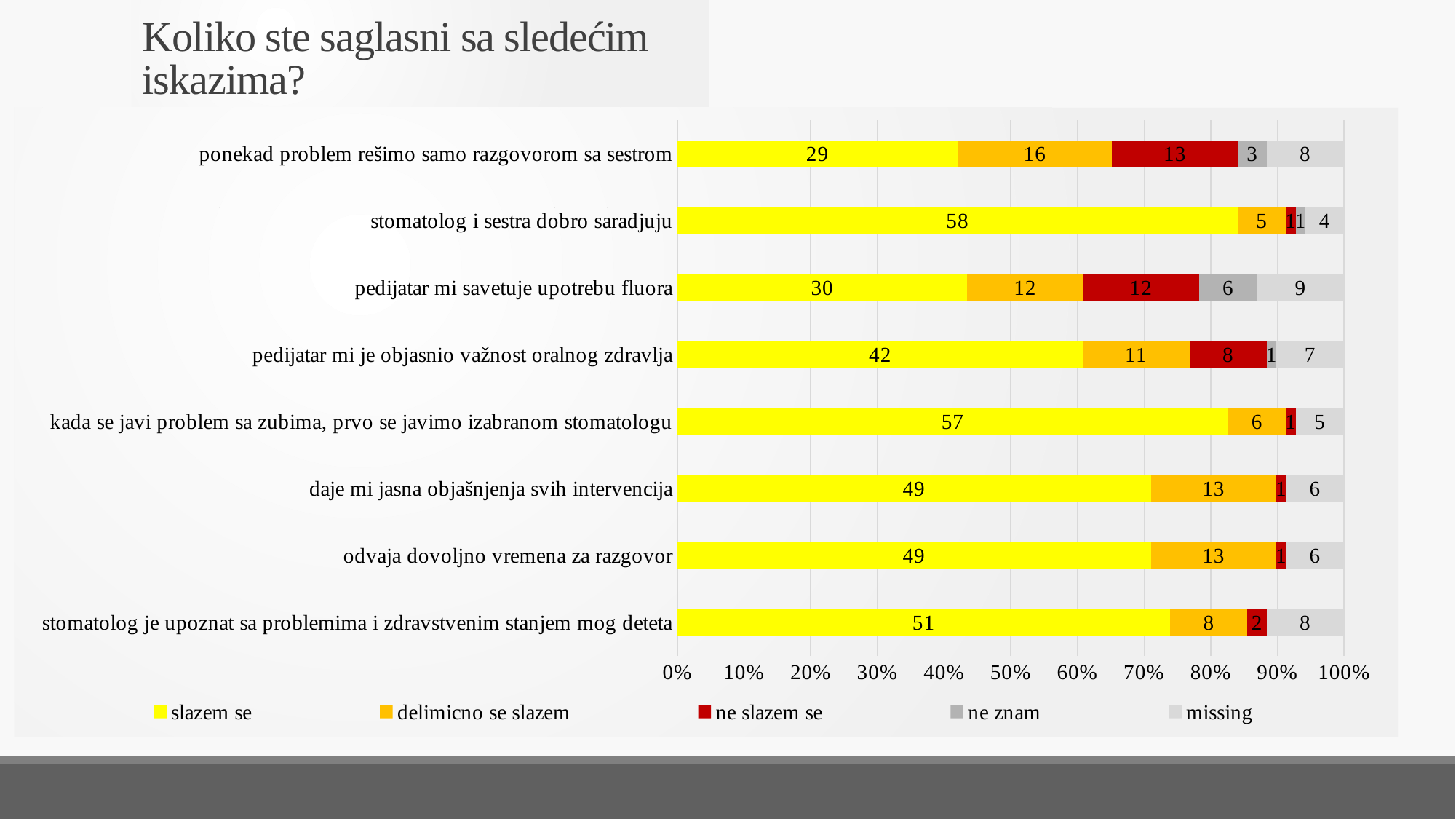
What is the 'slazem se' value for 'stomatolog i sestra dobro saradjuju'? 58 How many statements (categories) are shown in the chart? 8 What is the 'ne slazem se' value for 'ponekad problem rešimo samo razgovorom sa sestrom'? 13 What is the 'missing' value for 'pedijatar mi savetuje upotrebu fluora'? 9 What type of chart is shown on the slide? stacked bar chart How many series does the legend list? 5 Which statement has the lowest 'slazem se' value? ponekad problem rešimo samo razgovorom sa sestrom What is the 'delimicno se slazem' value for 'pedijatar mi je objasnio važnost oralnog zdravlja'? 11 Which colour represents 'ne slazem se' in the legend? red What is the difference between the 'slazem se' values for 'stomatolog i sestra dobro saradjuju' and 'ponekad problem rešimo samo razgovorom sa sestrom'? 29 Which statement has the highest 'slazem se' value? stomatolog i sestra dobro saradjuju Which has a larger 'ne znam' value: 'pedijatar mi savetuje upotrebu fluora' or 'ponekad problem rešimo samo razgovorom sa sestrom'? pedijatar mi savetuje upotrebu fluora